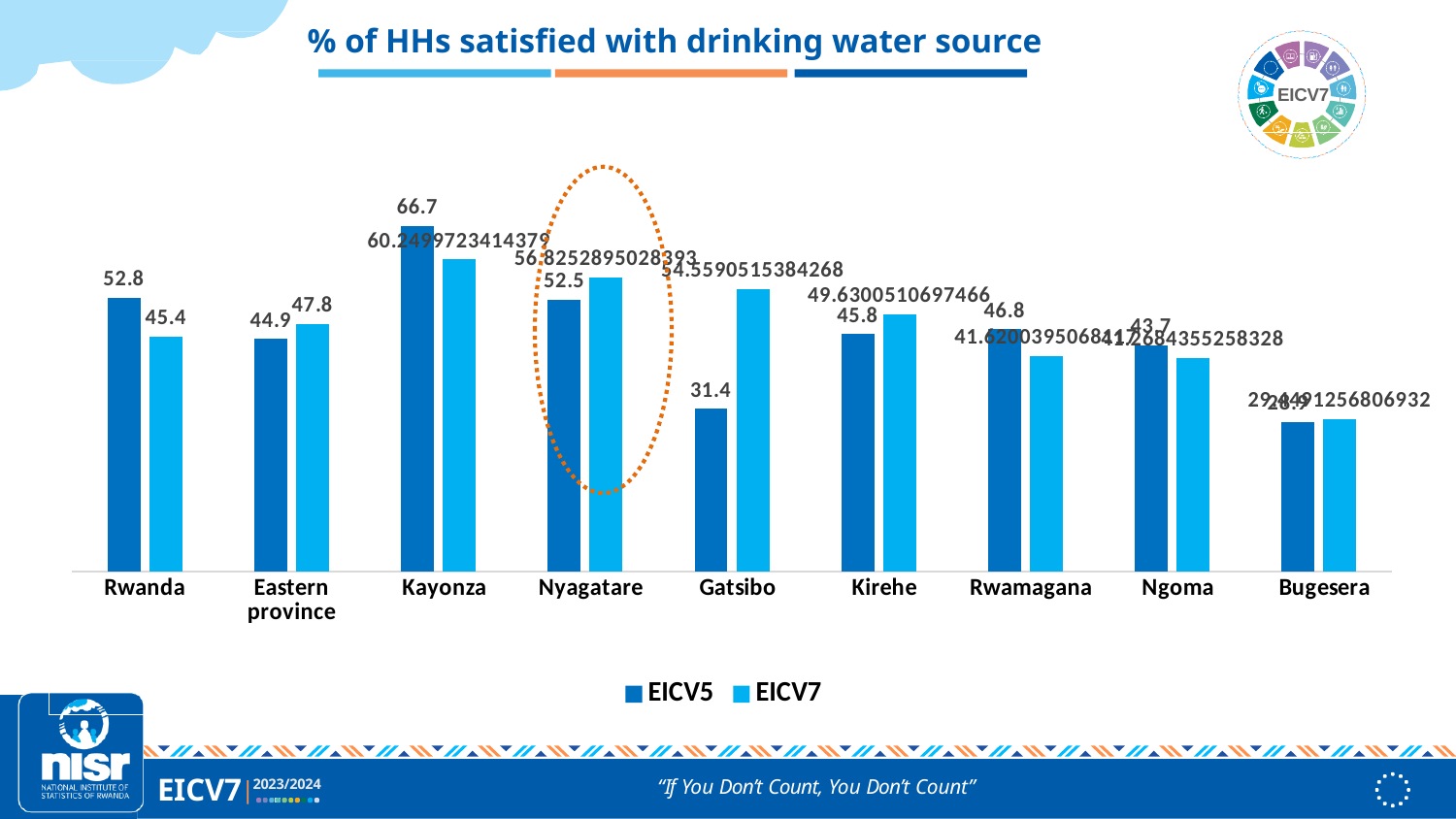
Which category has the highest EICV5 value? Kayonza For Eastern province, which is larger: the EICV5 value or the EICV7 value? EICV7 How many categories are shown on the x axis? 9 What is the difference between the EICV5 and EICV7 values for Rwanda? 7.4 What is the EICV5 value for Kirehe? 45.8 Which category is highlighted with a dotted orange circle? Nyagatare How many series does the legend list? 2 What kind of chart is shown on the slide? Bar chart What is the EICV5 value for Rwanda? 52.8 What is the EICV5 value for Gatsibo? 31.4 Which category has the lowest EICV5 value? Bugesera What is the EICV7 value for Rwanda? 45.4